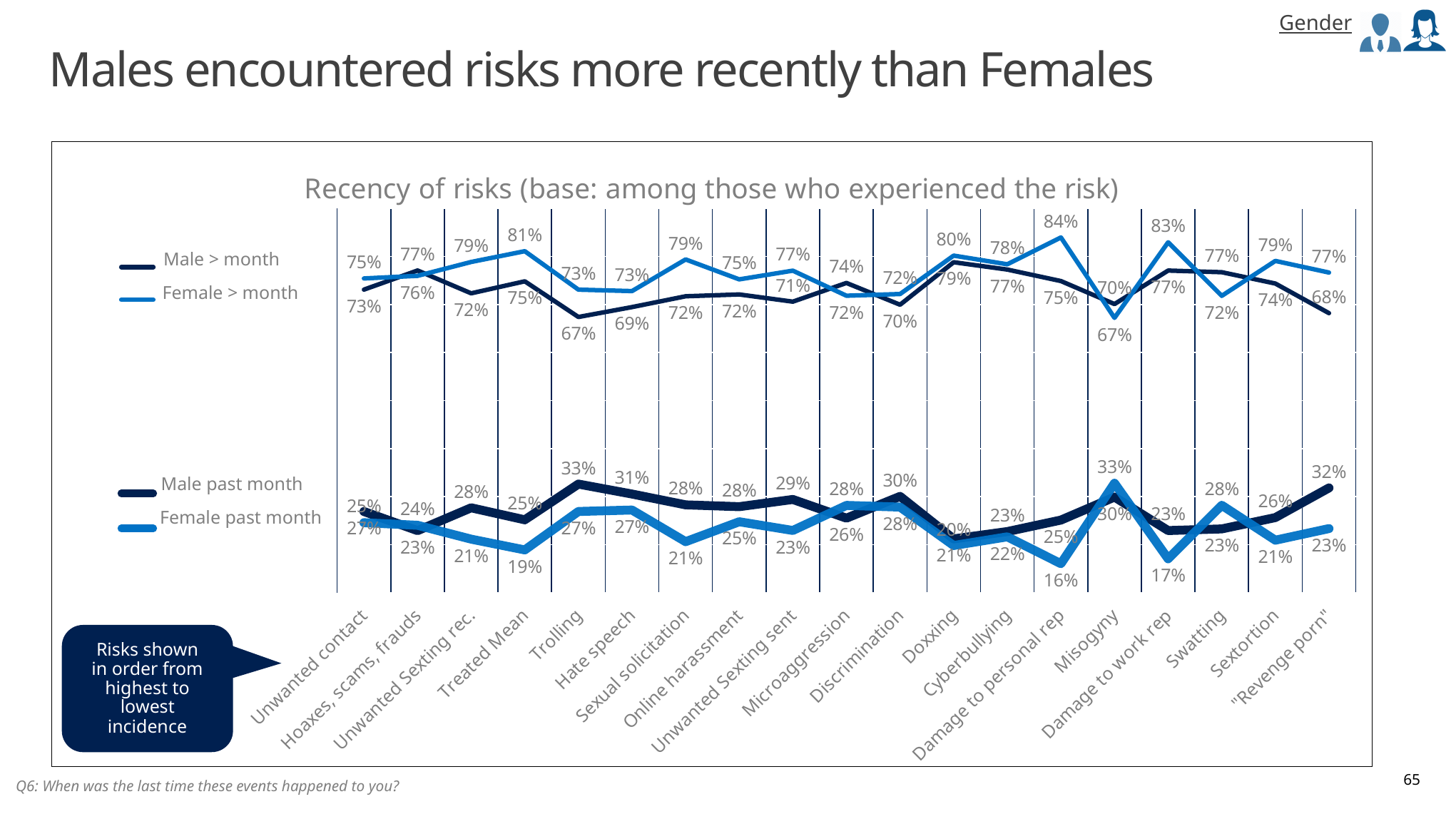
What is the Female > month value for Damage to personal rep? 84% What kind of chart is shown on the slide? Line chart How many series does the legend list? 4 What is the Female past month value for Damage to personal rep? 16% Which risk has the highest Male past month value? Trolling How many risk categories are plotted along the x axis? 19 For Swatting, which is larger: the Male > month value or the Female > month value? Male > month Which risk has the highest Female > month value? Damage to personal rep What is the Male > month value for Trolling? 67% Which risk has the lowest Female past month value? Damage to personal rep For "Revenge porn", what is the difference between the Female > month value and the Male > month value? 9 percentage points What is the title of the chart? Recency of risks (base: among those who experienced the risk)